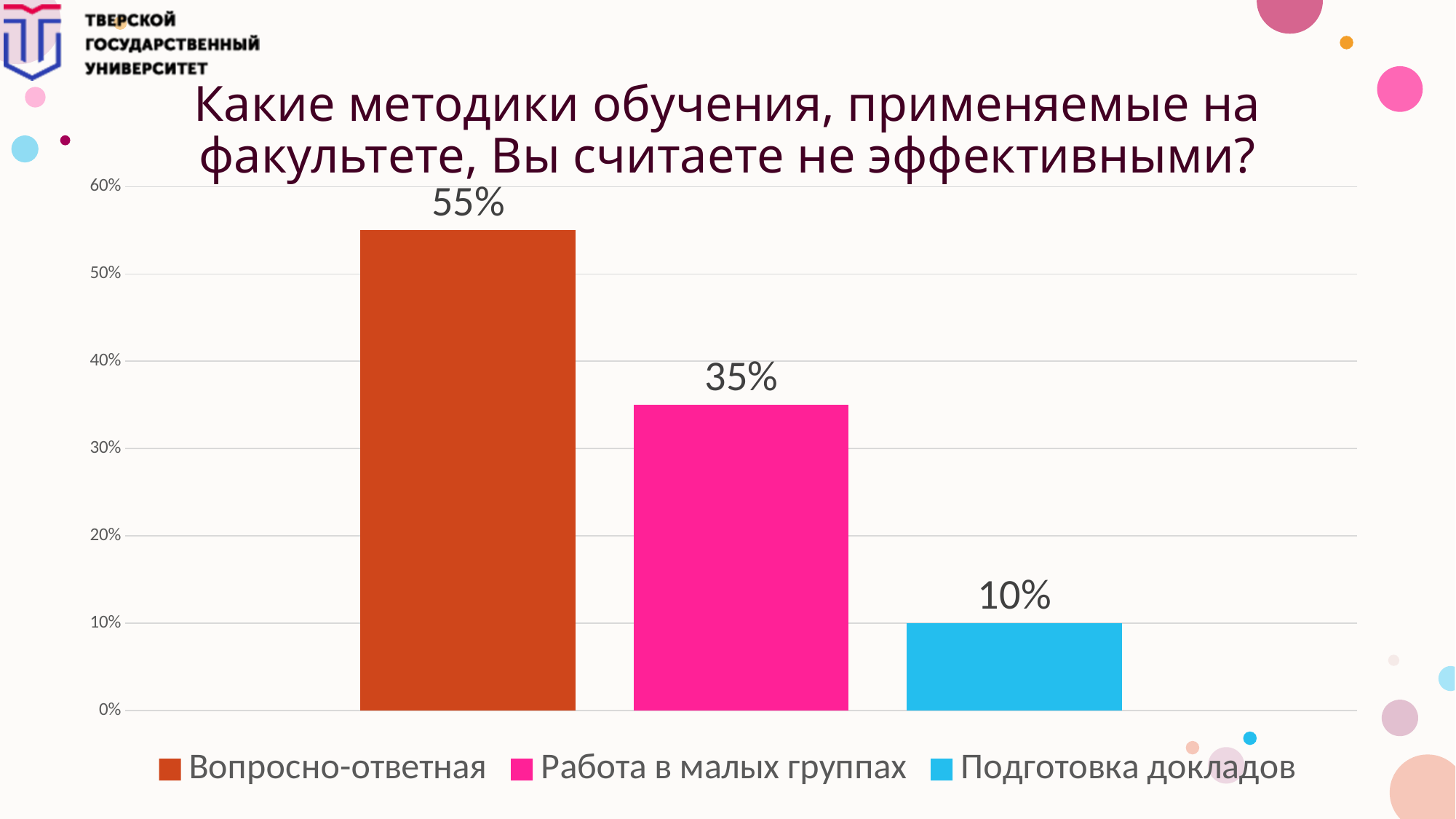
How many bars are shown in the chart? 3 Is the value for Вопросно-ответная greater or less than 50%? greater What colour is the bar for Подготовка докладов? light blue What is the difference between the values for Работа в малых группах and Подготовка докладов? 25% What is the difference between the values for Вопросно-ответная and Работа в малых группах? 20% Which is larger, the value for Работа в малых группах or the value for Подготовка докладов? Работа в малых группах What is the value for Подготовка докладов? 10% What is the value for Вопросно-ответная? 55% What kind of chart is shown on the slide? bar chart Which category has the lowest value? Подготовка докладов What is the value for Работа в малых группах? 35% Which category has the highest value? Вопросно-ответная